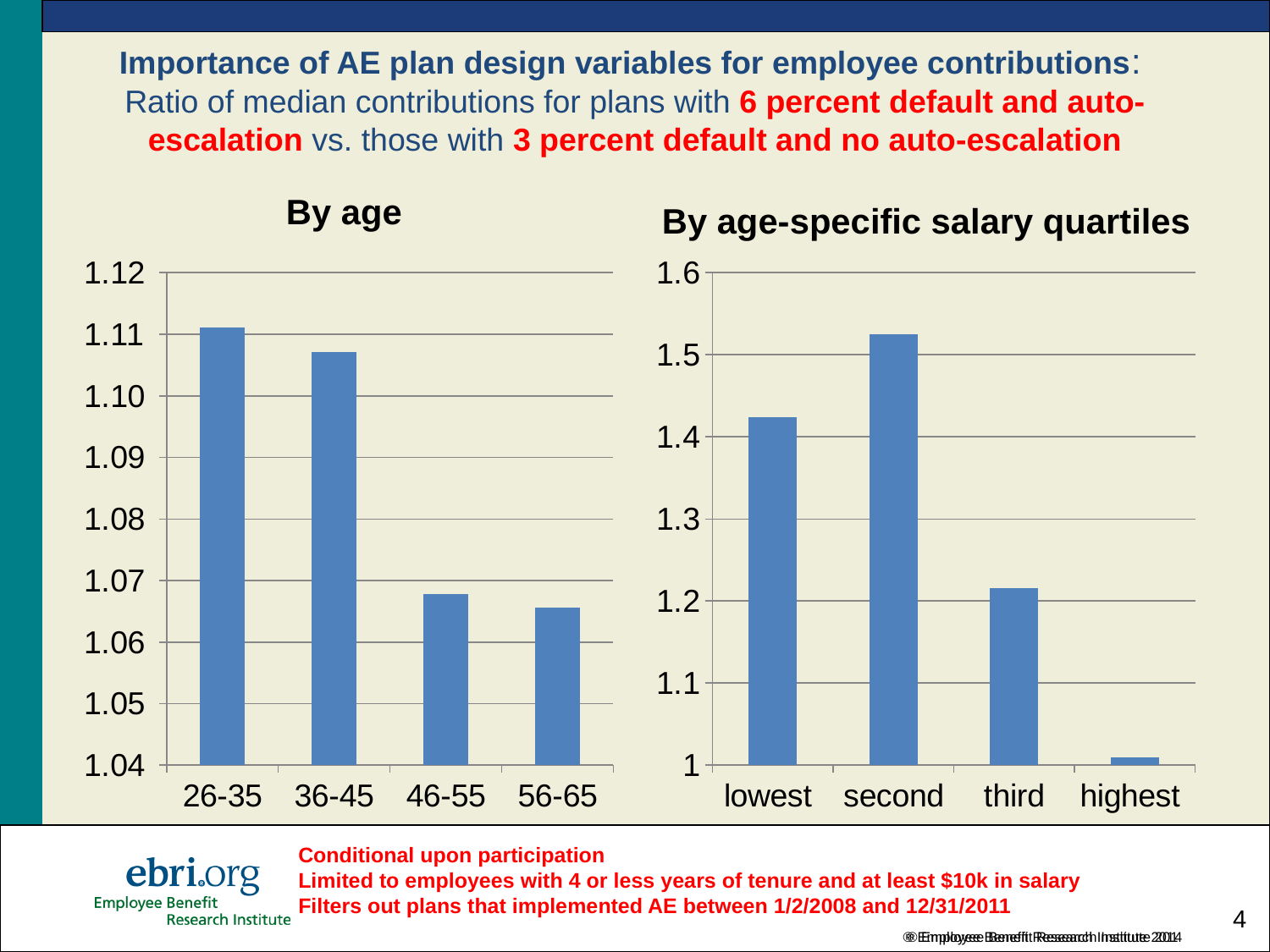
What type of chart is the "By age" chart? bar chart In the "By age" chart, which age group has the highest ratio? 26-35 In the "By age" chart, which is larger, the value for 26-35 or the value for 56-65? 26-35 In the "By age-specific salary quartiles" chart, which is larger, the value for lowest or the value for third? lowest In the "By age-specific salary quartiles" chart, which quartile has the highest ratio? second In the "By age" chart, do the values generally rise or fall as age increases? fall In the "By age" chart, how many age groups are shown? 4 In the "By age" chart, is the value for 46-55 greater or less than 1.07? less In the "By age-specific salary quartiles" chart, is the value for third greater or less than 1.3? less In the "By age-specific salary quartiles" chart, is the value for lowest greater or less than 1.4? greater In the "By age-specific salary quartiles" chart, which quartile has the lowest ratio? highest